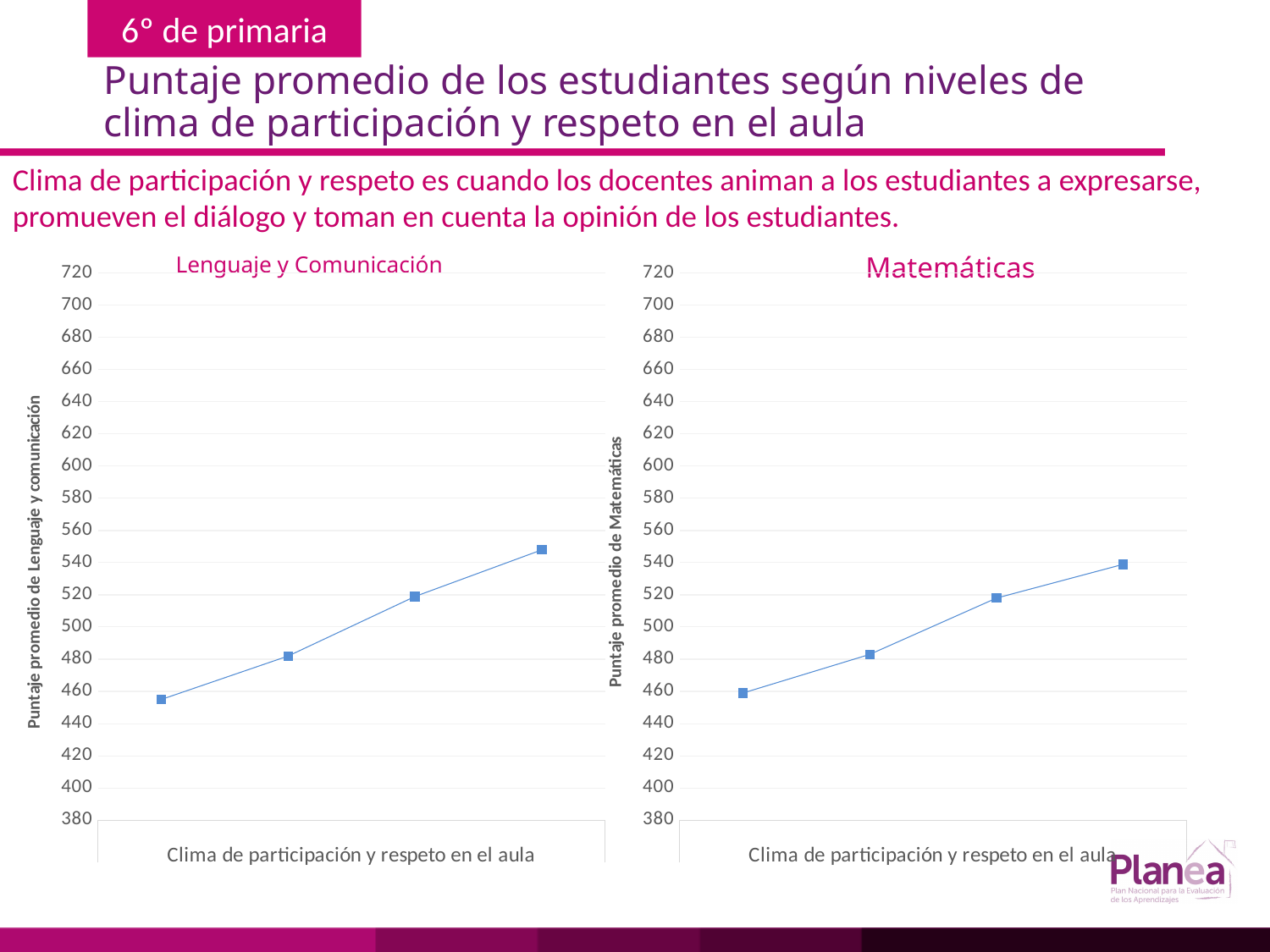
What is the title of the chart on the right side of the slide? Matemáticas In the Lenguaje y Comunicación chart, is the value of the last (rightmost) point greater or less than 540? greater What kind of chart is the Lenguaje y Comunicación chart? line chart How many data points are plotted in the Lenguaje y Comunicación chart? 4 In the Matemáticas chart, is the value of the last (rightmost) point greater or less than 520? greater In the Lenguaje y Comunicación chart, is the value of the first (leftmost) point greater or less than 460? less How many data points are plotted in the Matemáticas chart? 4 In the Lenguaje y Comunicación chart, do the values rise or fall from left to right along the x axis? rise In the Matemáticas chart, do the values rise or fall from left to right along the x axis? rise What is the y-axis title of the Lenguaje y Comunicación chart? Puntaje promedio de Lenguaje y comunicación What kind of chart is the Matemáticas chart? line chart